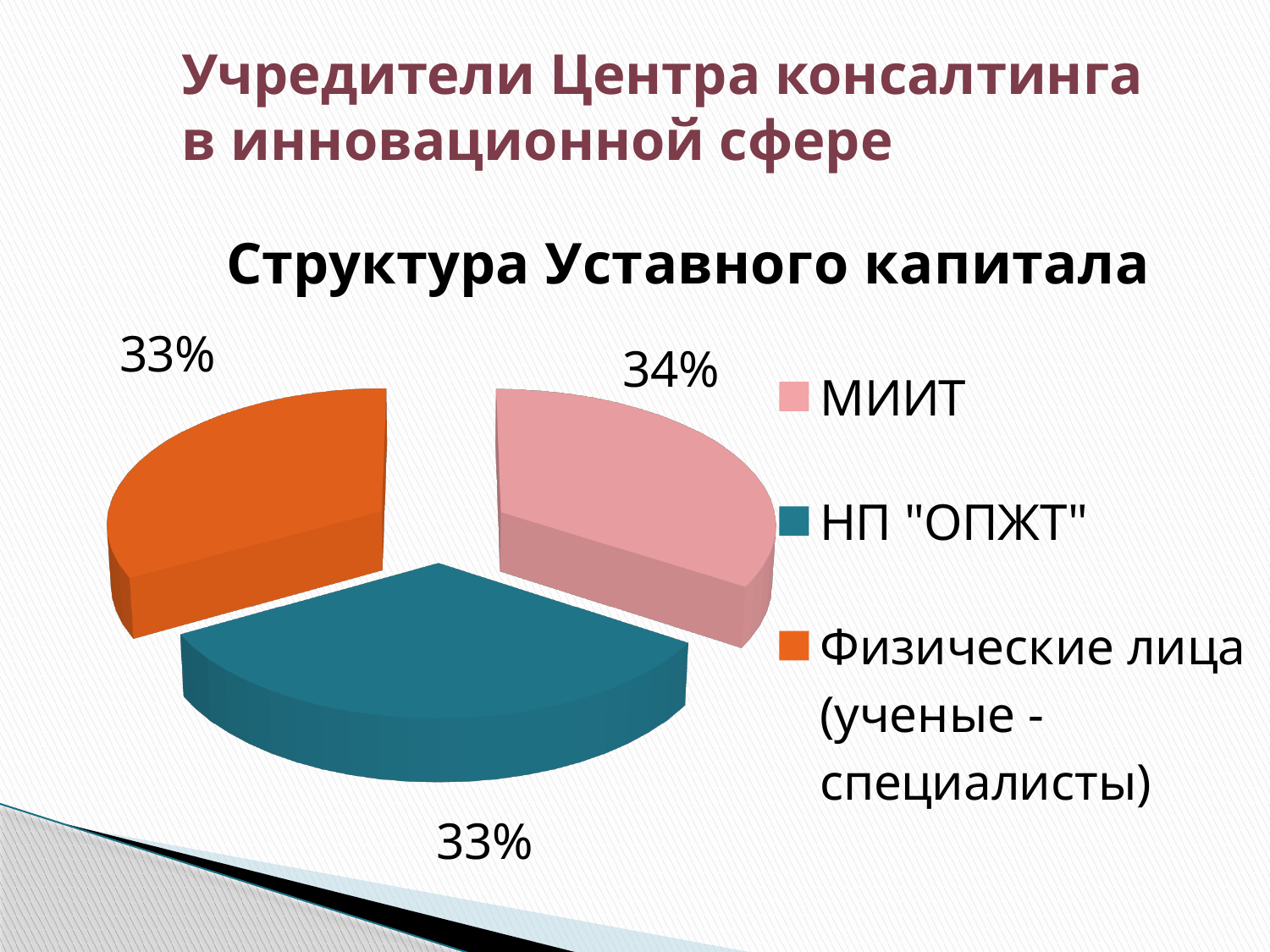
What share of the pie does НП "ОПЖТ" hold? 33% Is the share of МИИТ greater or less than 30%? greater What is the difference between the share of МИИТ and the share of Физические лица (ученые - специалисты)? 1% Which category has the largest share of the pie? МИИТ What share of the pie does МИИТ hold? 34% What share of the pie do Физические лица (ученые - специалисты) hold? 33% How many slices does the pie chart have? 3 What kind of chart is shown on the slide? Pie chart How many entries does the legend list? 3 Which is larger, the share of МИИТ or the share of НП "ОПЖТ"? МИИТ What is the title of the chart? Структура Уставного капитала Which colour represents НП "ОПЖТ" in the chart? Teal